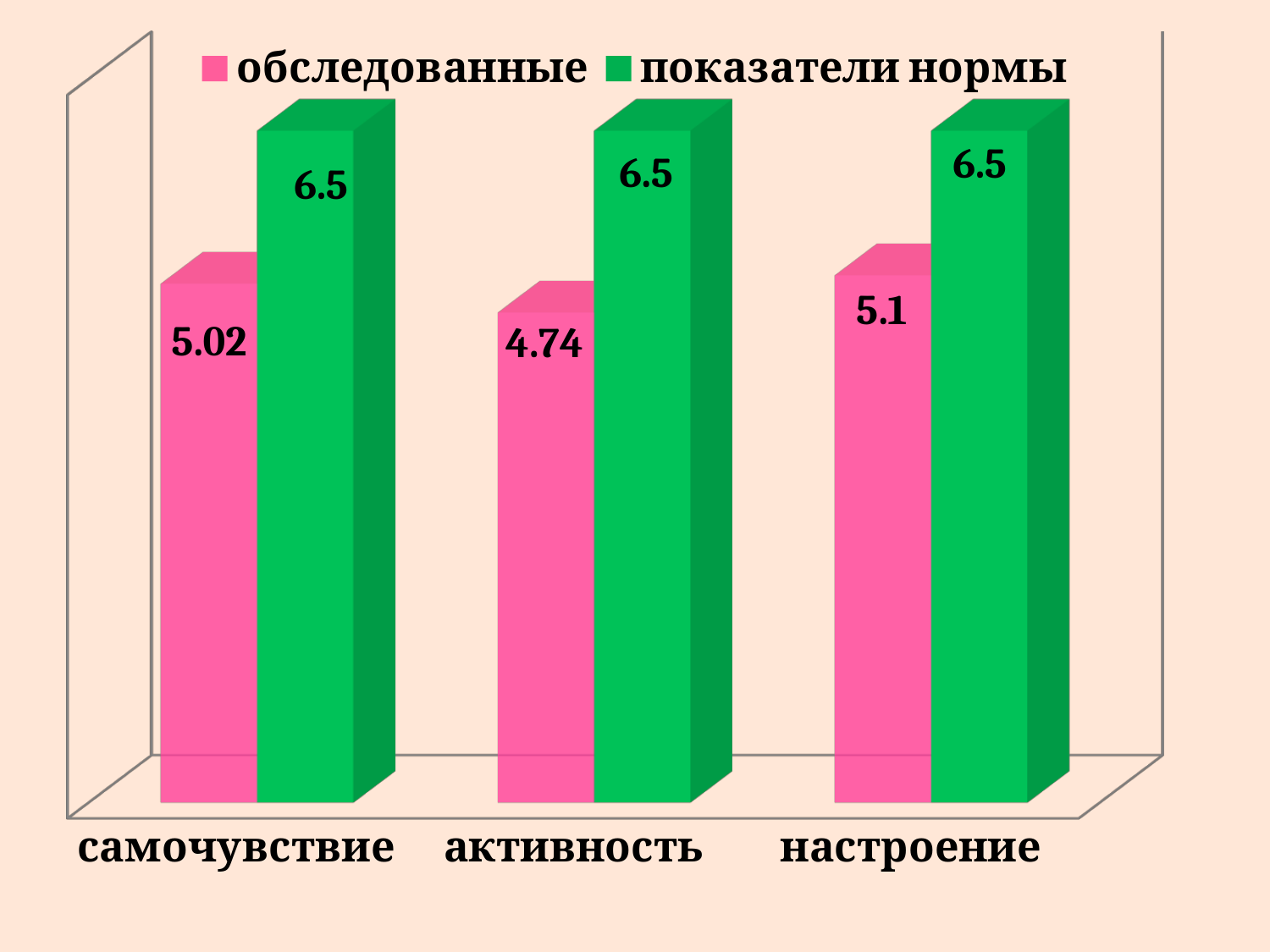
What is the value for обследованные in the активность category? 4.74 How many series does the legend list? 2 How many categories are shown on the x axis? 3 What is the value for обследованные in the самочувствие category? 5.02 What is the value for показатели нормы in the активность category? 6.5 Which category has the lowest value for обследованные? активность Which category has the highest value for обследованные? настроение What is the difference between показатели нормы and обследованные in the самочувствие category? 1.48 What kind of chart is shown on the slide? bar chart What is the difference between показатели нормы and обследованные in the активность category? 1.76 Which is larger in the настроение category: обследованные or показатели нормы? показатели нормы What is the value for обследованные in the настроение category? 5.1